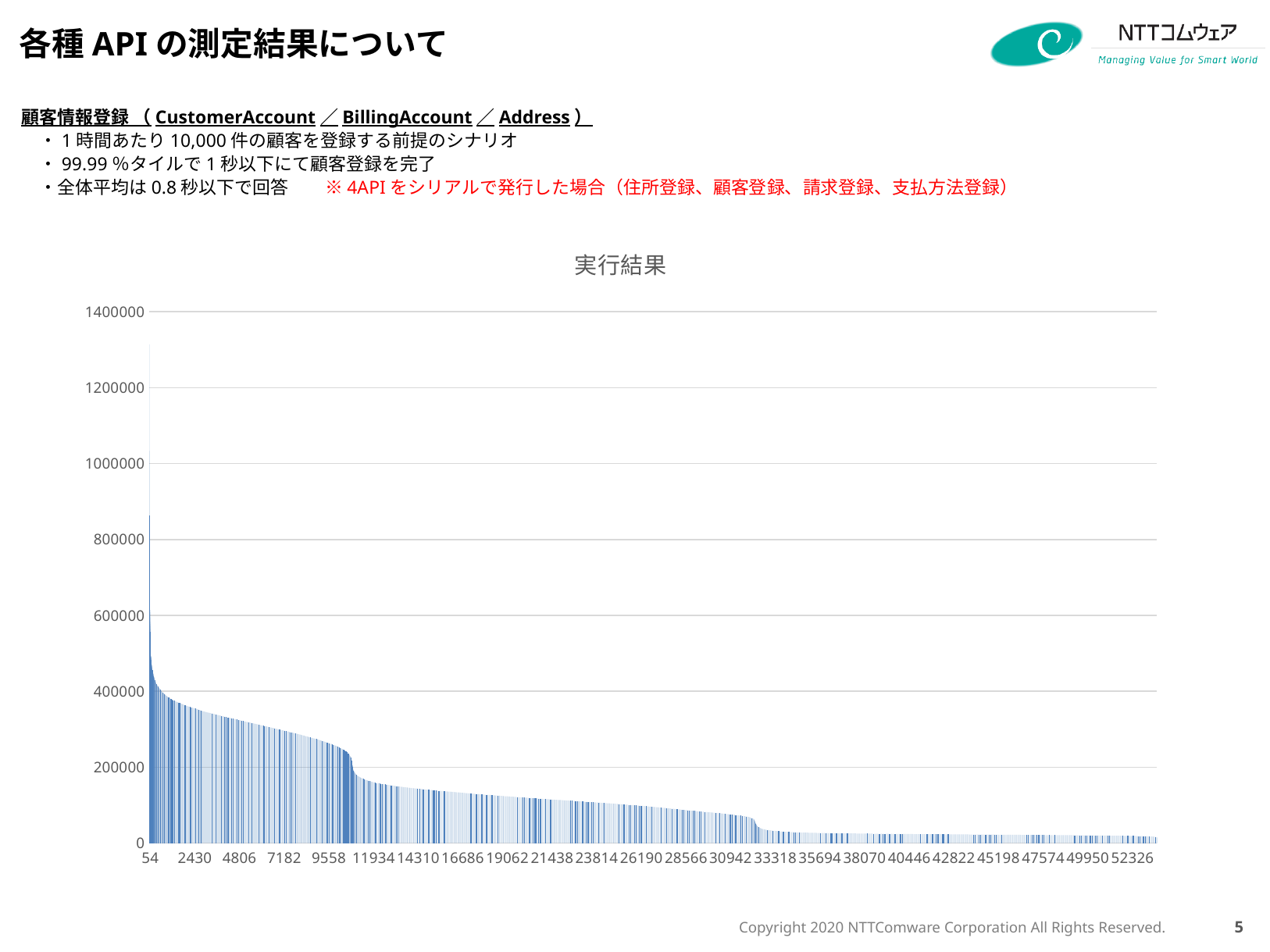
Is the value at x-axis label 33318 greater or less than 200000? less What is the highest value shown on the y axis? 1400000 Is the value at x-axis label 9558 greater or less than 400000? less What kind of chart is shown on the slide? bar chart What is the title of the chart? 実行結果 Is the value at x-axis label 2430 greater or less than 600000? less Do the values rise or fall moving from left to right along the x axis? fall Is the value at x-axis label 2430 larger or smaller than the value at x-axis label 33318? larger Which x-axis label corresponds to the tallest bar in the chart? 54